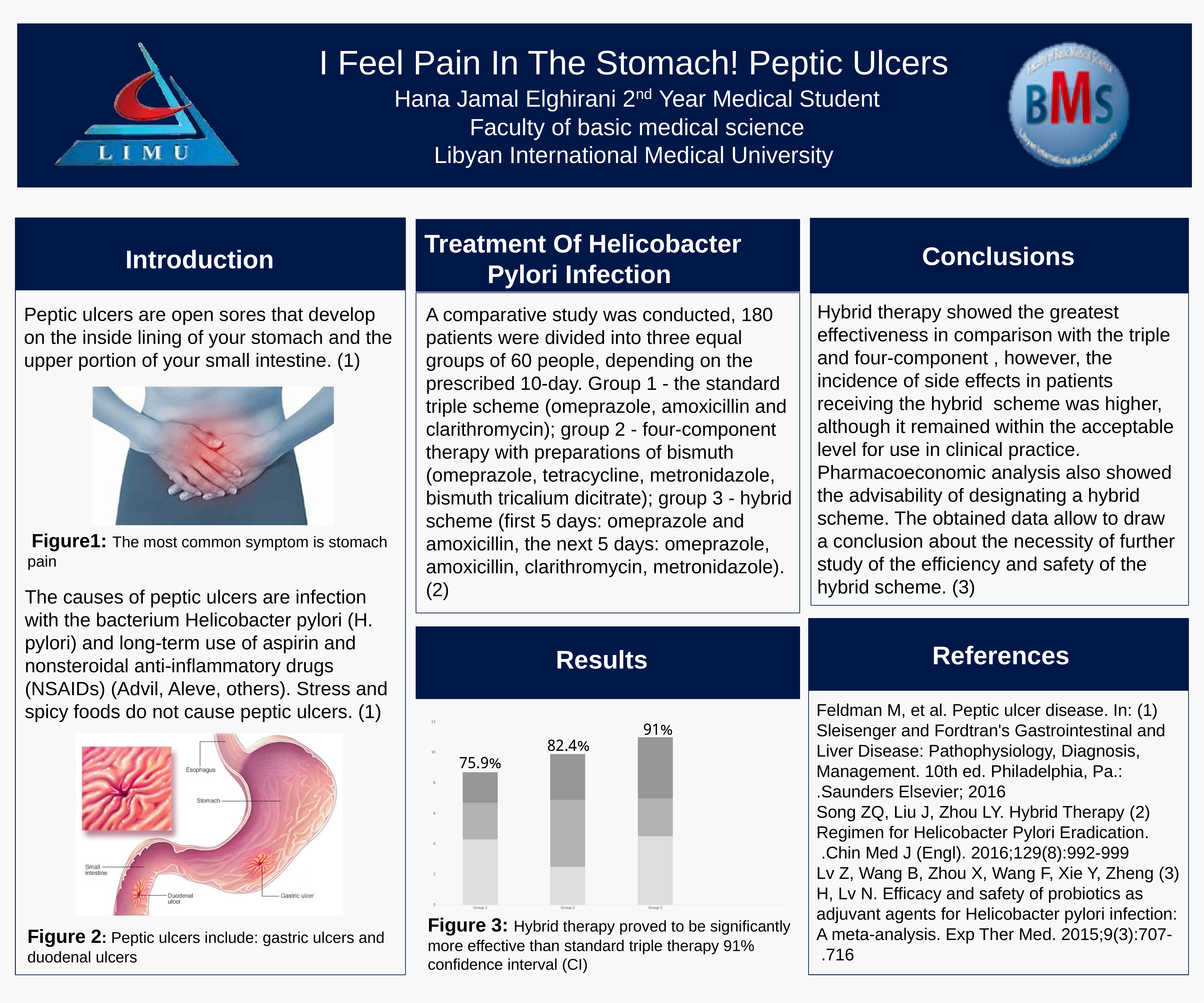
Do the labelled values rise or fall from Group 1 to Group 3? rise What kind of chart is shown in the Results section? bar chart What value is labelled above the bar for Group 1? 75.9% What value is labelled above the bar for Group 3? 91% What value is labelled above the bar for Group 2? 82.4% What is the difference between the labelled values for Group 2 and Group 1? 6.5% What is the difference between the labelled values for Group 3 and Group 1? 15.1% Which group has the highest labelled value? Group 3 Which group has the lowest labelled value? Group 1 Which has the larger labelled value, Group 2 or Group 1? Group 2 Is the top of the bar for Group 3 greater or less than 10 on the y axis? greater How many groups are shown on the x axis of the chart? 3